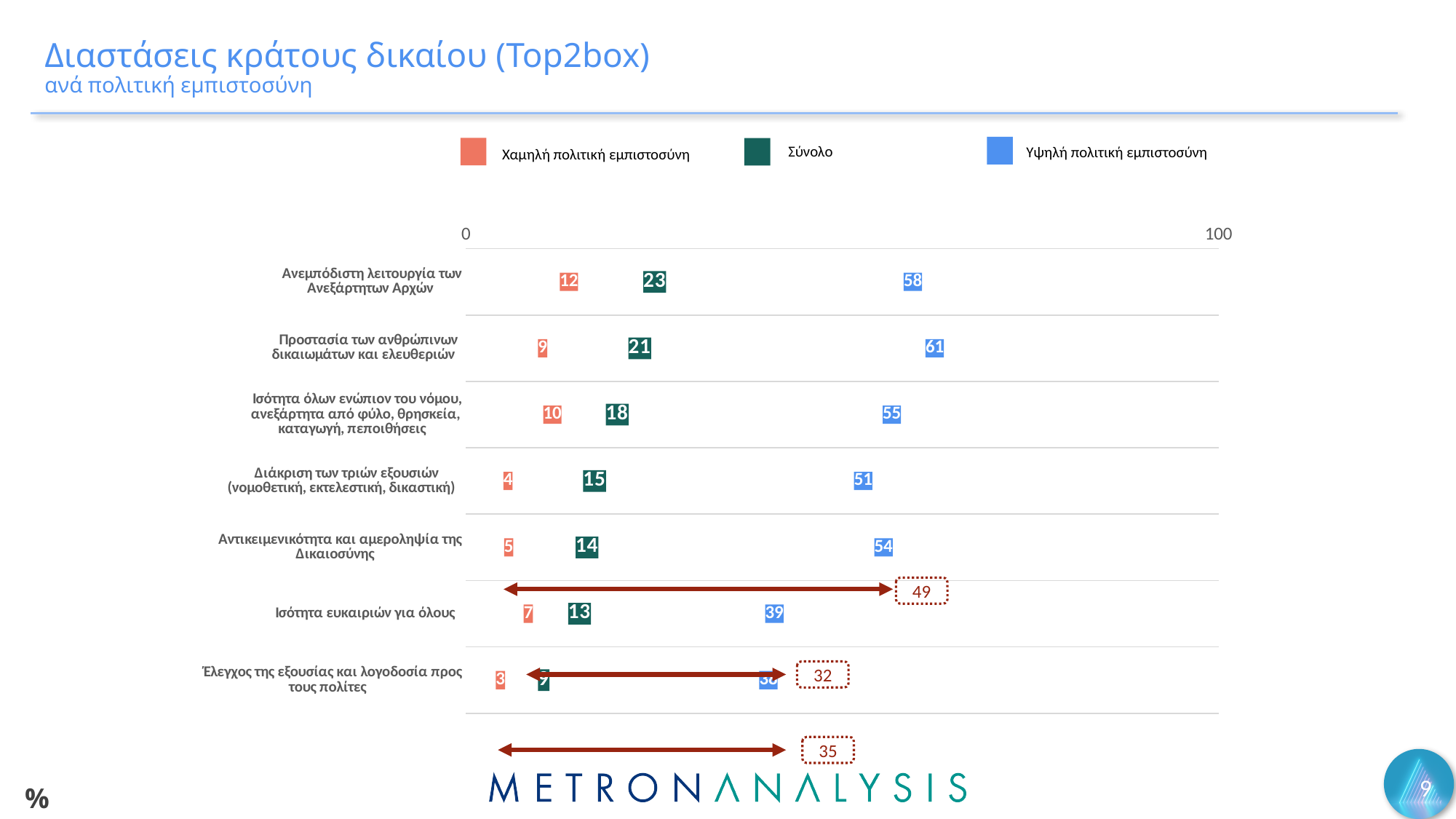
How many categories are shown on the chart? 7 What is the Σύνολο value for Ανεμπόδιστη λειτουργία των Ανεξάρτητων Αρχών? 23 Which category has the highest Υψηλή πολιτική εμπιστοσύνη value? Προστασία των ανθρώπινων δικαιωμάτων και ελευθεριών What colour represents the Σύνολο series in the legend? Dark green What is the Χαμηλή πολιτική εμπιστοσύνη value for Ισότητα ευκαιριών για όλους? 7 How many series does the legend list? 3 What is the Υψηλή πολιτική εμπιστοσύνη value for Προστασία των ανθρώπινων δικαιωμάτων και ελευθεριών? 61 What is the difference between the Υψηλή and Χαμηλή πολιτική εμπιστοσύνη values for Ισότητα ευκαιριών για όλους? 32 Which has the larger Σύνολο value: Ισότητα όλων ενώπιον του νόμου or Διάκριση των τριών εξουσιών? Ισότητα όλων ενώπιον του νόμου What is the Χαμηλή πολιτική εμπιστοσύνη value for Διάκριση των τριών εξουσιών? 4 What is the difference between the Υψηλή and Χαμηλή πολιτική εμπιστοσύνη values for Αντικειμενικότητα και αμεροληψία της Δικαιοσύνης? 49 Which category has the lowest Σύνολο value? Έλεγχος της εξουσίας και λογοδοσία προς τους πολίτες